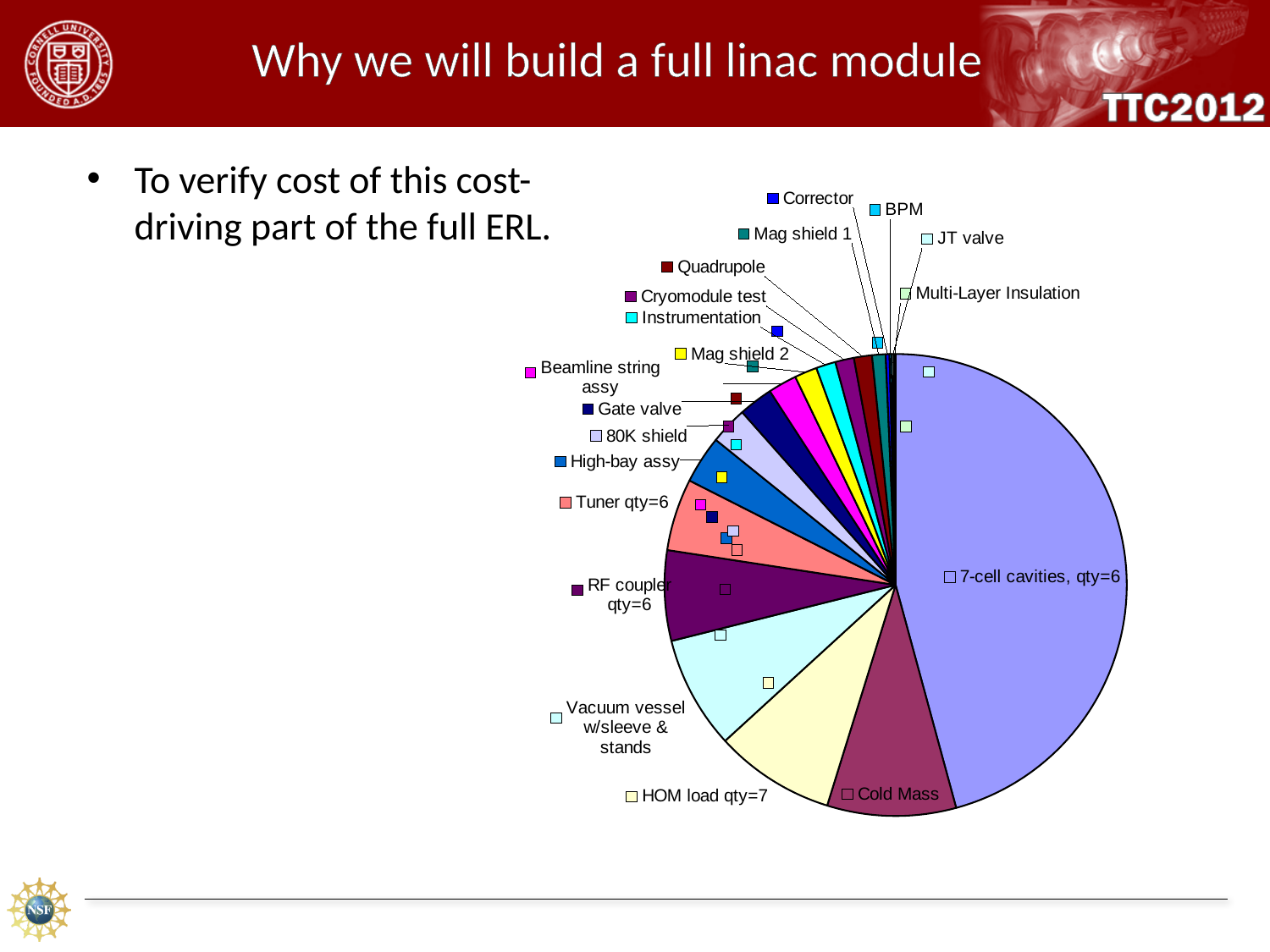
What kind of chart is shown on the slide? pie chart Which slice is larger, Vacuum vessel w/sleeve & stands or RF coupler qty=6? Vacuum vessel w/sleeve & stands What quantity is listed in the label for the HOM load slice? qty=7 What is the title of the slide containing the pie chart? Why we will build a full linac module Which category has the largest slice of the pie? 7-cell cavities, qty=6 Which slice is larger, 7-cell cavities, qty=6 or Cold Mass? 7-cell cavities, qty=6 Which slice is larger, Tuner qty=6 or High-bay assy? Tuner qty=6 How many categories (slices) does the pie chart have? 19